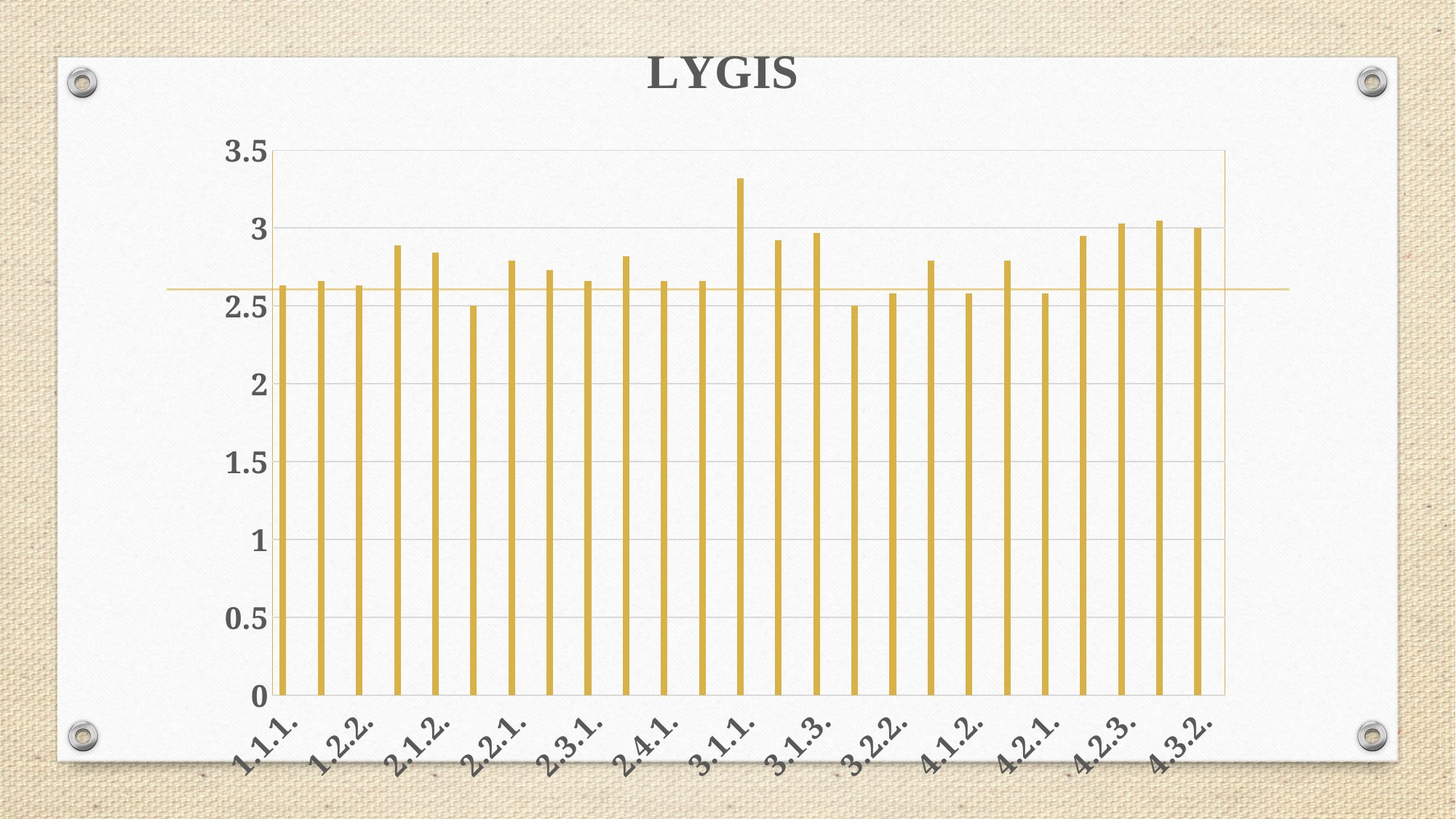
What kind of chart is shown on the slide? bar chart Which has the larger value, 3.1.1. or 3.2.2.? 3.1.1. Which category has the highest value in the chart? 3.1.1. Is the value for 3.2.2. greater or less than 3? less Is the value for 4.2.1. greater or less than 2? greater Which has the larger value, 4.2.3. or 4.1.2.? 4.2.3. Which has the larger value, 2.1.2. or 2.3.1.? 2.1.2. What is the title of the chart? LYGIS Is the value for 2.1.2. greater or less than 2.5? greater What colour are the bars in the chart? gold